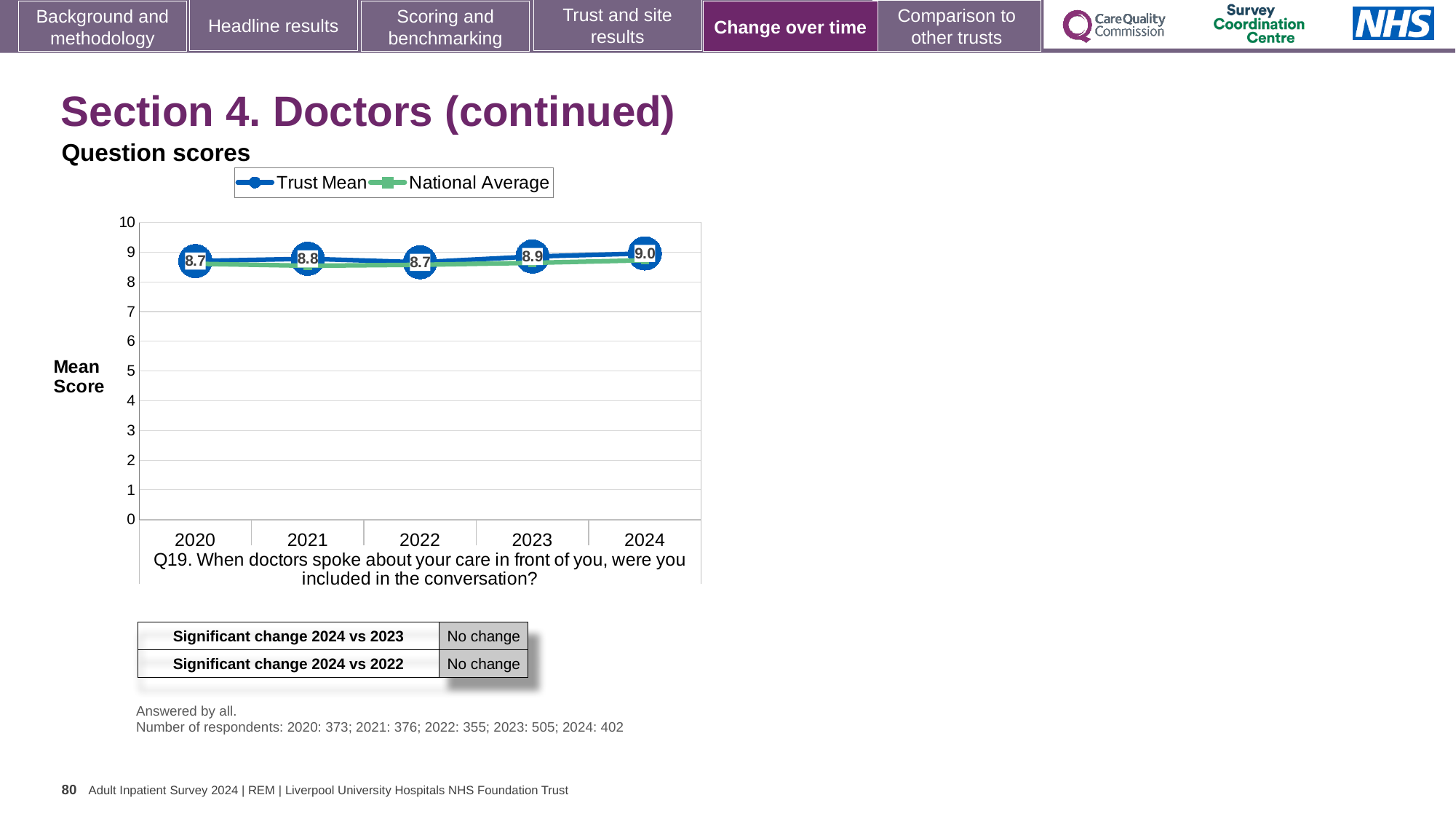
How many series does the chart legend list? 2 How many years are shown on the x axis of the chart? 5 Is the National Average value for 2024 greater or less than 8? greater In which year is the Trust Mean score highest? 2024 Does the Trust Mean score rise or fall overall from 2020 to 2024? Rise Which year has the larger Trust Mean score, 2021 or 2023? 2023 What is the Trust Mean score for 2024? 9.0 What is the difference between the Trust Mean score in 2024 and in 2020? 0.3 What kind of chart is shown on the slide? Line chart What is the Trust Mean score for 2020? 8.7 What is the label on the y axis of the chart? Mean Score What is the Trust Mean score for 2023? 8.9